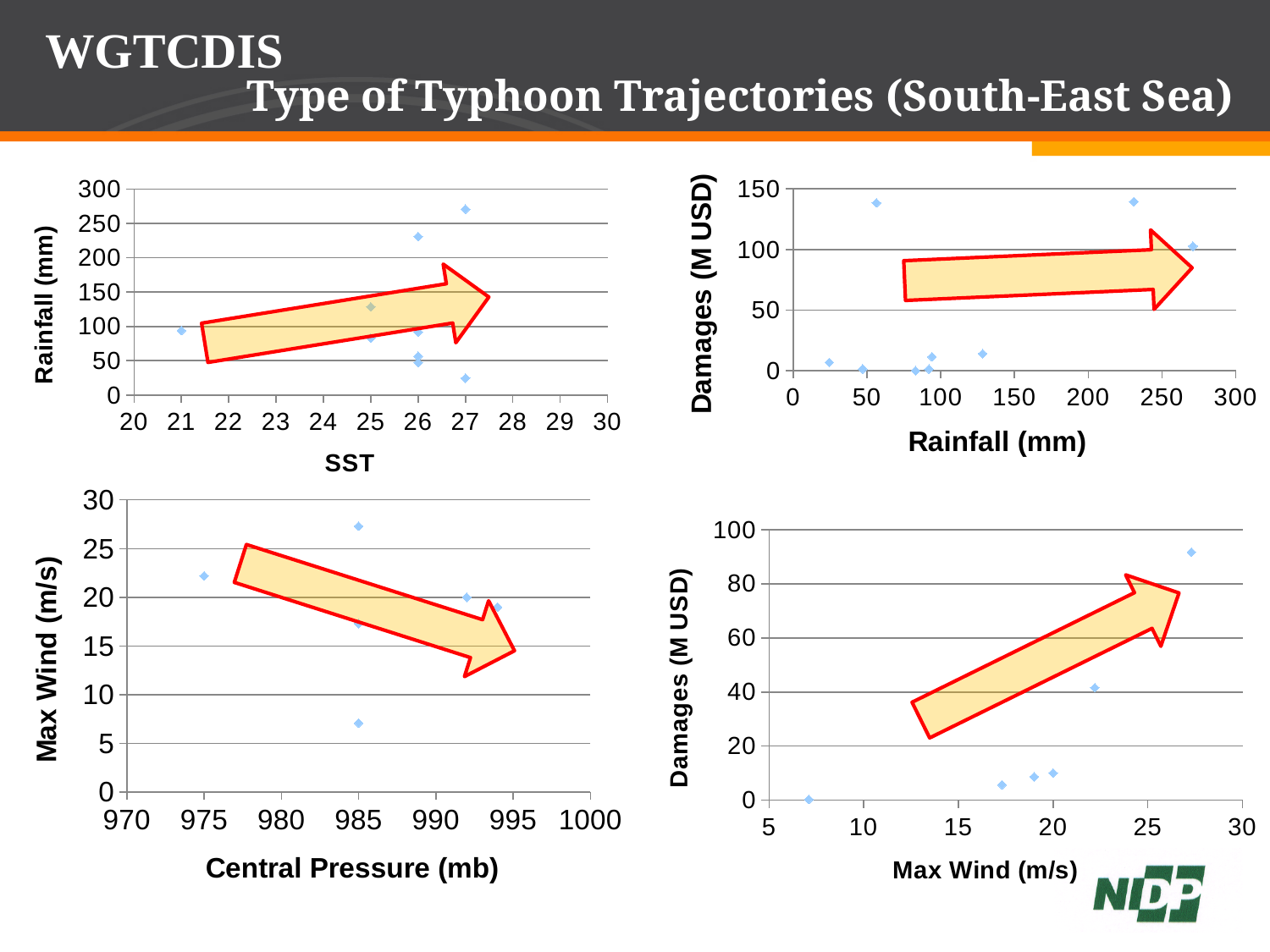
What kind of chart is the top-left chart (Rainfall vs SST)? scatter chart In the top-left chart, is the rainfall value of the highest point greater or less than 250? greater What is the y-axis label of the bottom-right chart? Damages (M USD) In the bottom-left chart, is the max wind value of the lowest point greater or less than 10? less In the bottom-right chart (Damages vs Max Wind), do damages generally rise or fall as max wind increases? rise In the top-right chart (Damages vs Rainfall), do damages generally rise or fall as rainfall increases? rise In the bottom-right chart, is the damages value of the highest point greater or less than 80? greater In the top-left chart, at which SST value does the point with the highest rainfall occur? 27 In the top-left chart (Rainfall vs SST), does rainfall generally rise or fall as SST increases? rise What is the x-axis label of the bottom-left chart? Central Pressure (mb)